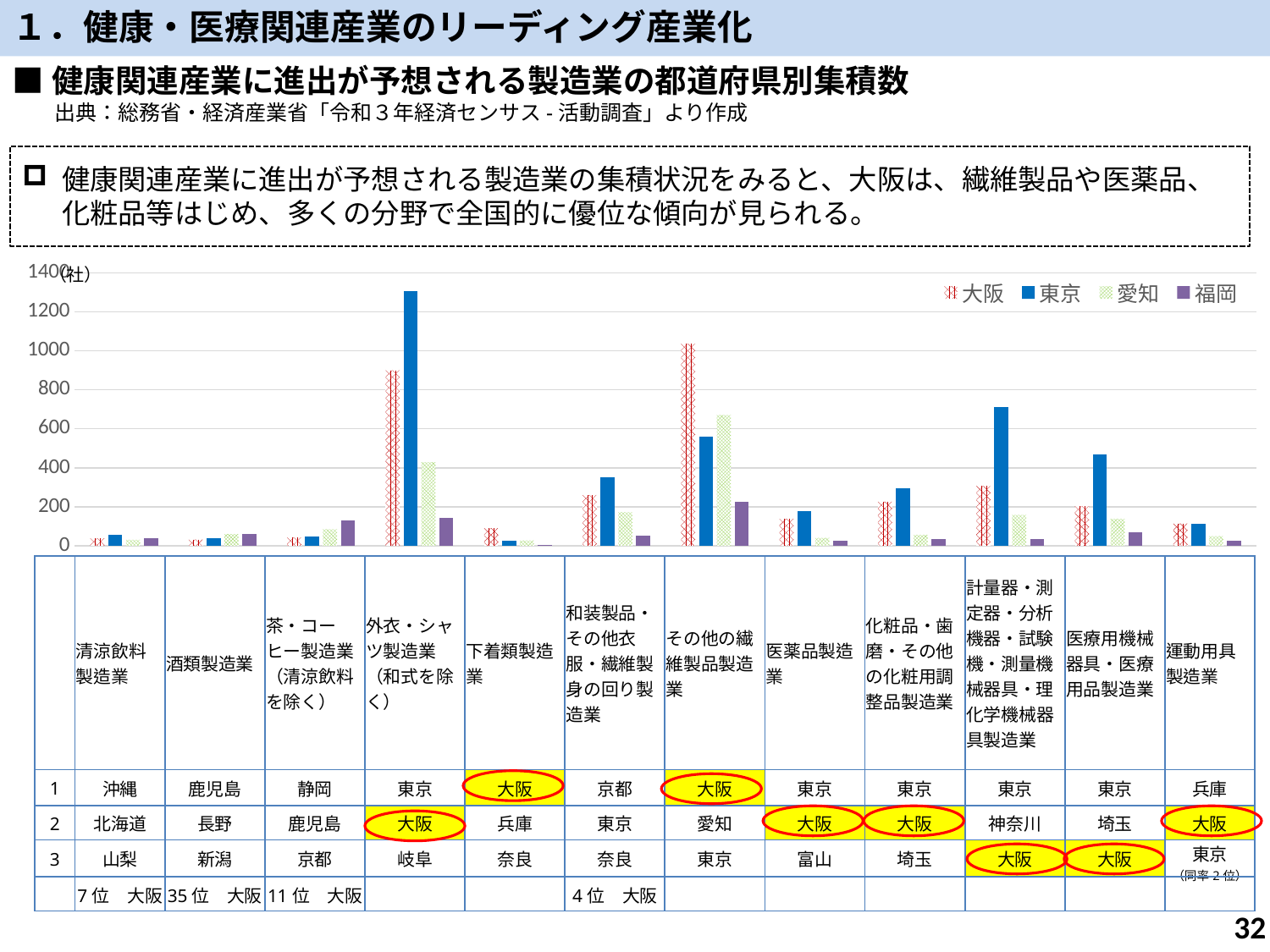
Is the value for 大阪 in その他の繊維製品製造業 greater or less than 800? greater What kind of chart is shown on the slide? bar chart Which prefecture has the highest bar in the その他の繊維製品製造業 category? 大阪 How many industry categories are plotted along the x axis of the chart? 12 How many series does the chart legend list? 4 What unit is shown at the top of the vertical axis of the chart? 社 In which industry category does 東京 have its highest bar? 外衣・シャツ製造業（和式を除く） In the その他の繊維製品製造業 category, which is larger, the bar for 愛知 or the bar for 東京? 愛知 Which prefecture has the highest bar in the 医薬品製造業 category? 東京 Is the value for 東京 in 外衣・シャツ製造業（和式を除く） greater or less than 1200? greater Which prefectures are listed in the chart legend? 大阪, 東京, 愛知, 福岡